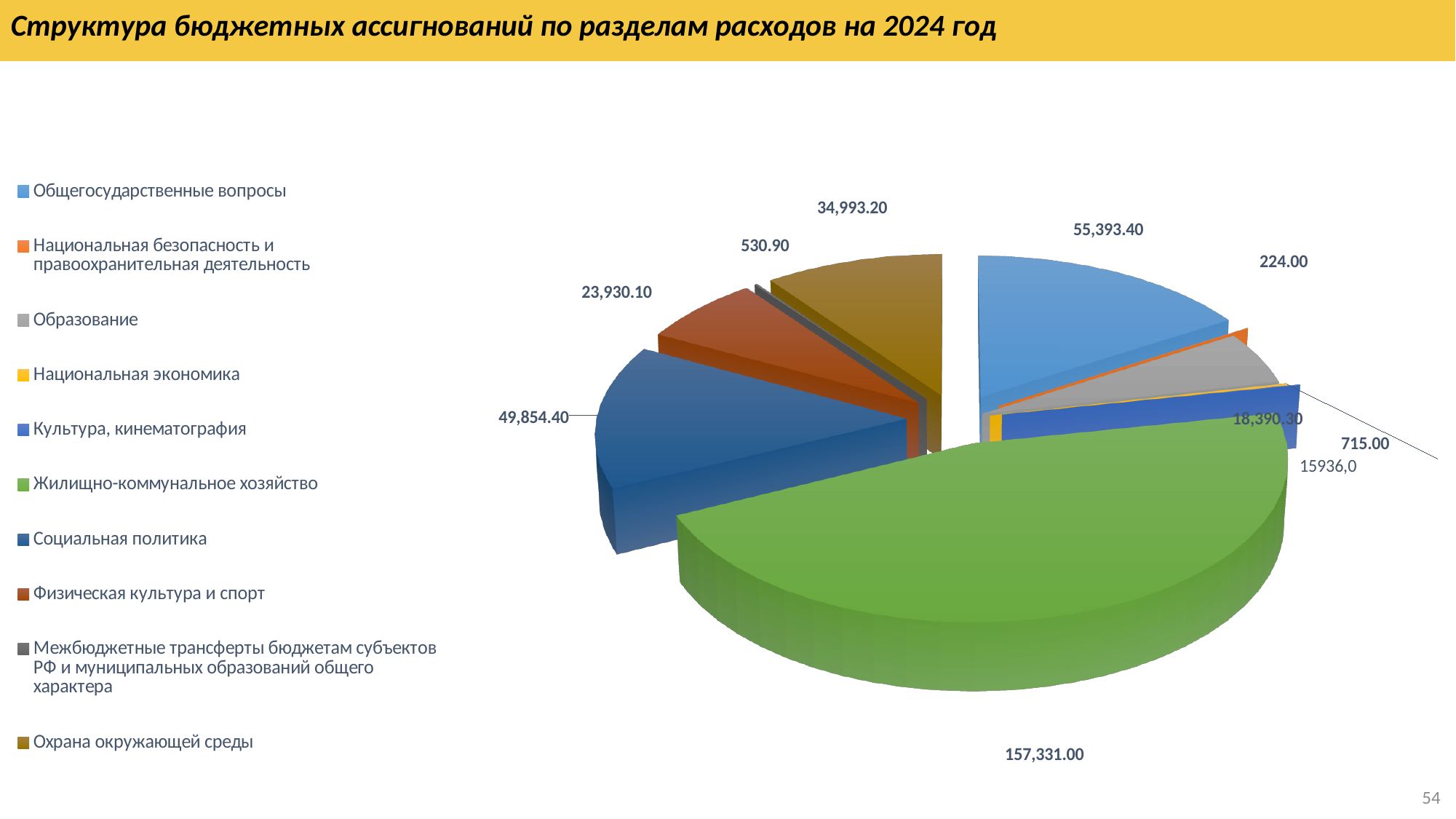
What is the value shown for Охрана окружающей среды? 34,993.20 What kind of chart is shown on the slide? Pie chart How many categories does the legend of the pie chart list? 10 Which category has the smallest value in the pie chart? Национальная безопасность и правоохранительная деятельность What is the difference between the values for Жилищно-коммунальное хозяйство and Общегосударственные вопросы? 101,937.60 What is the value shown for Социальная политика? 49,854.40 What is the title of the slide containing the pie chart? Структура бюджетных ассигнований по разделам расходов на 2024 год What is the value shown for Физическая культура и спорт? 23,930.10 Which category has the largest slice in the pie chart? Жилищно-коммунальное хозяйство Which is larger: the value for Социальная политика or the value for Охрана окружающей среды? Социальная политика What is the value shown for Жилищно-коммунальное хозяйство? 157,331.00 What is the value shown for Общегосударственные вопросы? 55,393.40